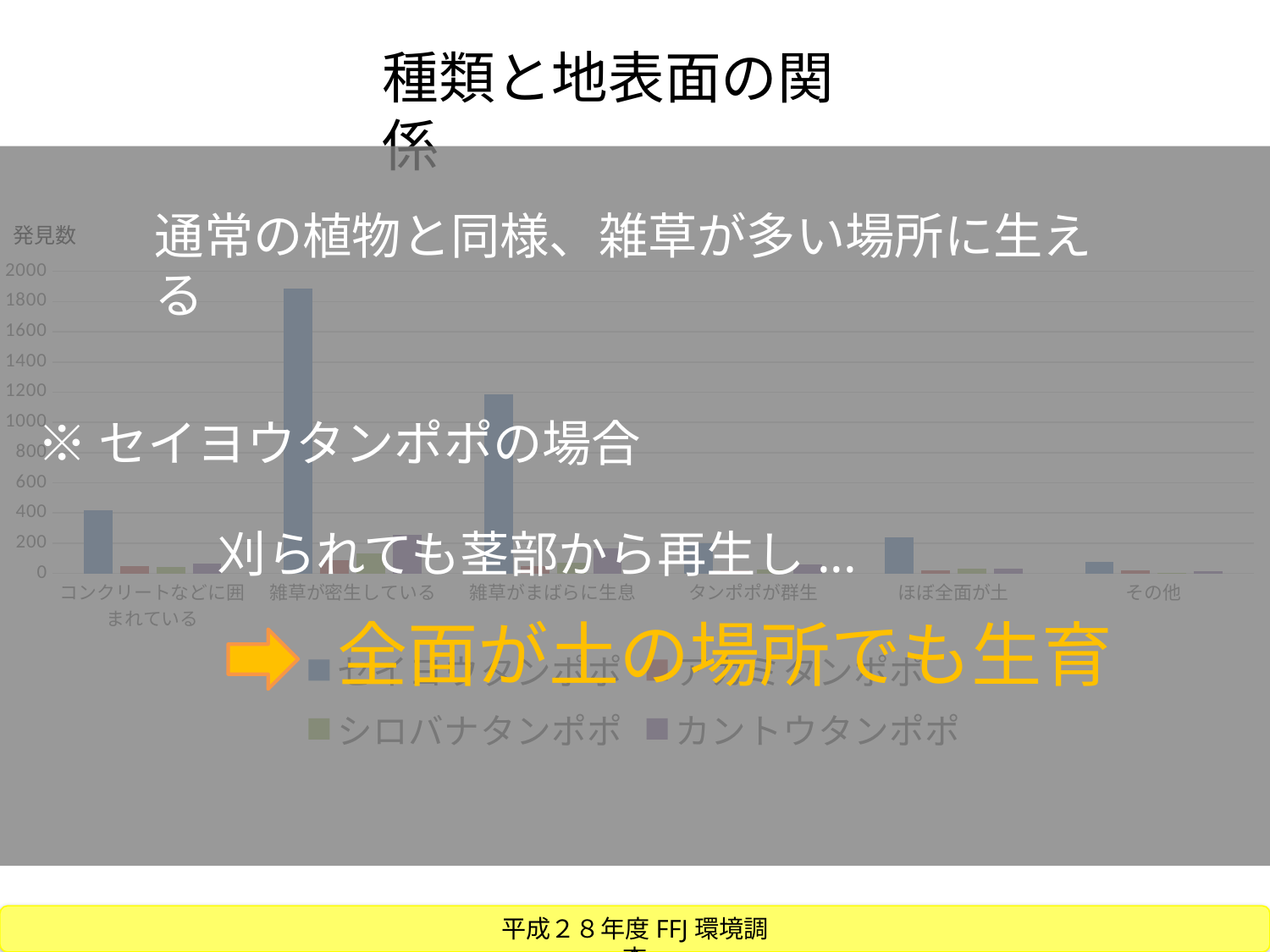
What kind of chart is shown on the slide? bar chart Is the value for セイヨウタンポポ in コンクリートなどに囲まれている greater or less than 600? less For セイヨウタンポポ, which category has the highest value? 雑草が密生している Is the value for セイヨウタンポポ in ほぼ全面が土 greater or less than 400? less Is the value for セイヨウタンポポ in 雑草がまばらに生息 greater or less than 1000? greater How many series does the chart's legend list? 4 How many categories are shown along the x axis of the chart? 6 For セイヨウタンポポ, which is larger: 雑草が密生している or 雑草がまばらに生息? 雑草が密生している What is the label on the chart's vertical axis? 発見数 For セイヨウタンポポ, which is larger: コンクリートなどに囲まれている or ほぼ全面が土? コンクリートなどに囲まれている